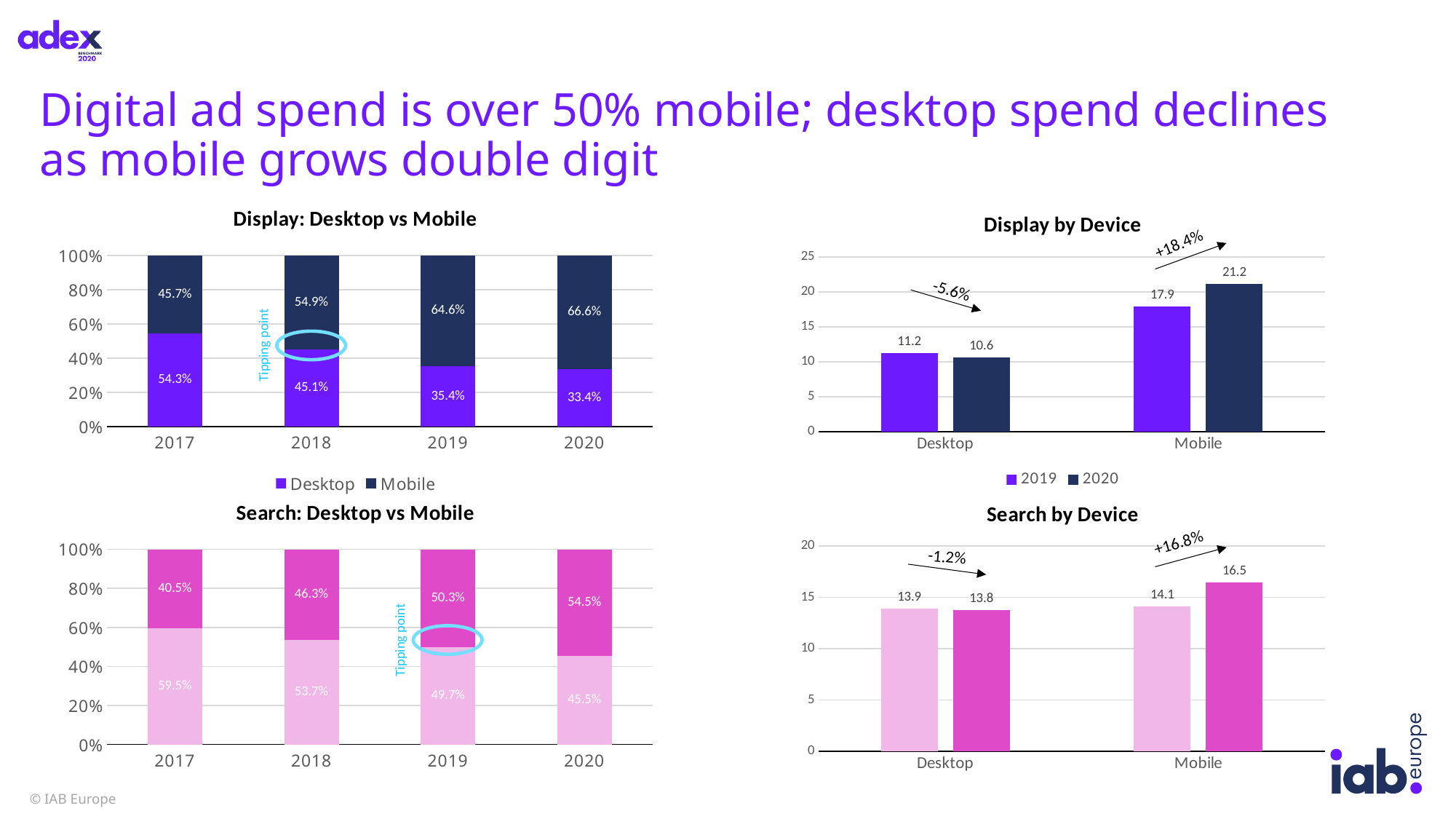
In the 'Display by Device' chart, what is the difference between the 2019 and 2020 values for Desktop? 0.6 In the 'Display: Desktop vs Mobile' chart, how many series does the legend list? 2 In the 'Display: Desktop vs Mobile' chart, what is the Desktop share in 2017? 54.3% In the 'Display: Desktop vs Mobile' chart, which year has the lowest Desktop share? 2020 In the 'Display: Desktop vs Mobile' chart, what is the difference between the Mobile share in 2019 and the Mobile share in 2018? 9.7% In the 'Search by Device' chart, which category has the highest bar? Mobile In the 'Display: Desktop vs Mobile' chart, does the Mobile share rise or fall from 2017 to 2020? rise What kind of chart is 'Search by Device'? bar chart In the 'Display: Desktop vs Mobile' chart, what is the Mobile share in 2020? 66.6% In the 'Search: Desktop vs Mobile' chart, what is the value of the top (darker pink) segment in 2020? 54.5% In the 'Display by Device' chart, what is the 2020 value for Mobile? 21.2 In the 'Search: Desktop vs Mobile' chart, how many years are shown on the x axis? 4